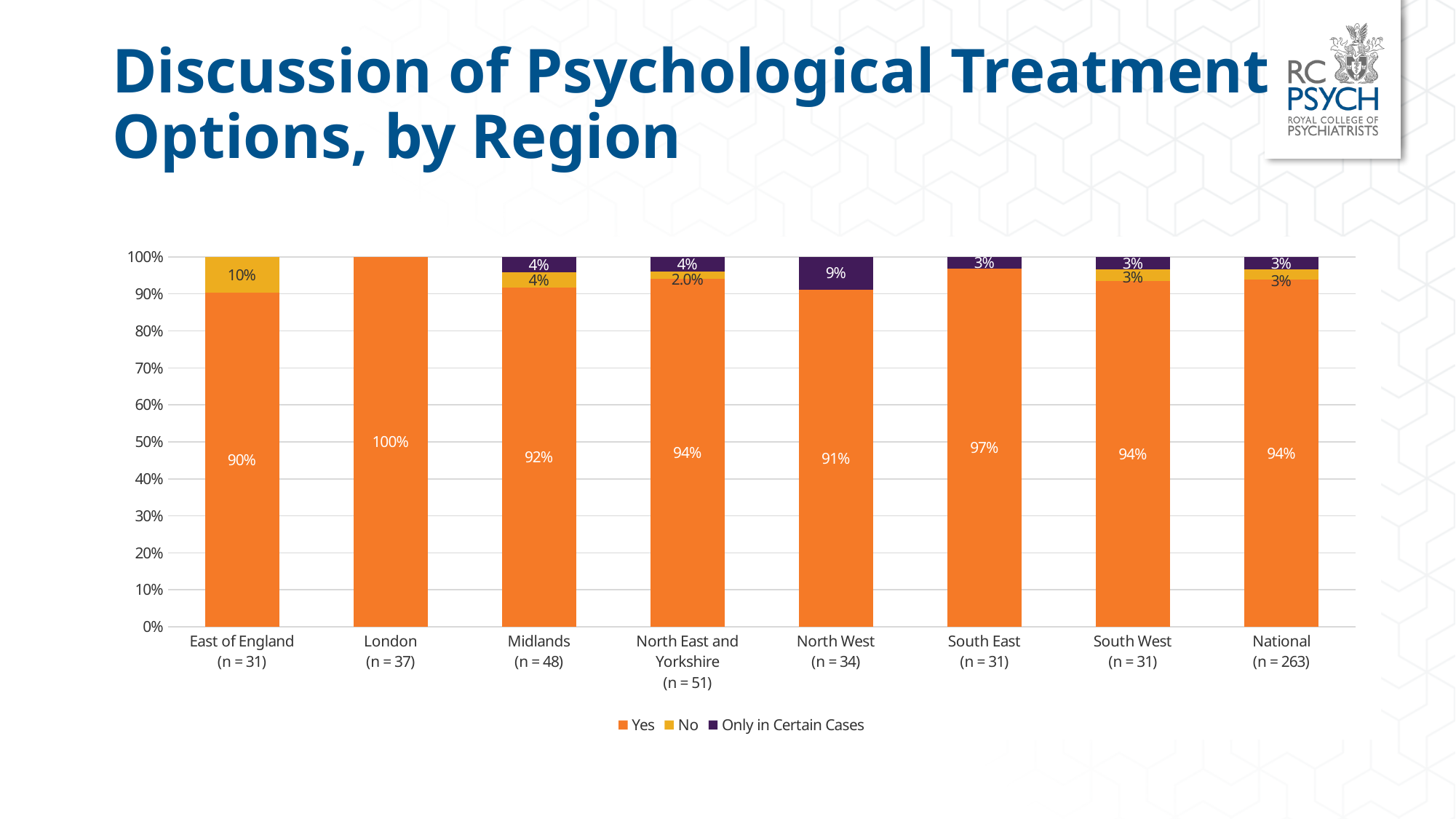
How many categories are shown on the x axis? 8 What is the "No" value for the East of England? 10% What is the "Only in Certain Cases" value for the North West? 9% Which region has the highest "Yes" percentage? London How many series does the legend list? 3 Which region has the lowest "Yes" percentage? East of England What is the "No" value for North East and Yorkshire? 2.0% What percentage of respondents in the East of England answered "Yes"? 90% What is the "Yes" value for the National category? 94% What is the difference between the "Yes" value for South East and the "Yes" value for North West? 6% Which has a larger "Yes" value, Midlands or South East? South East What kind of chart is shown on the slide? Stacked bar chart